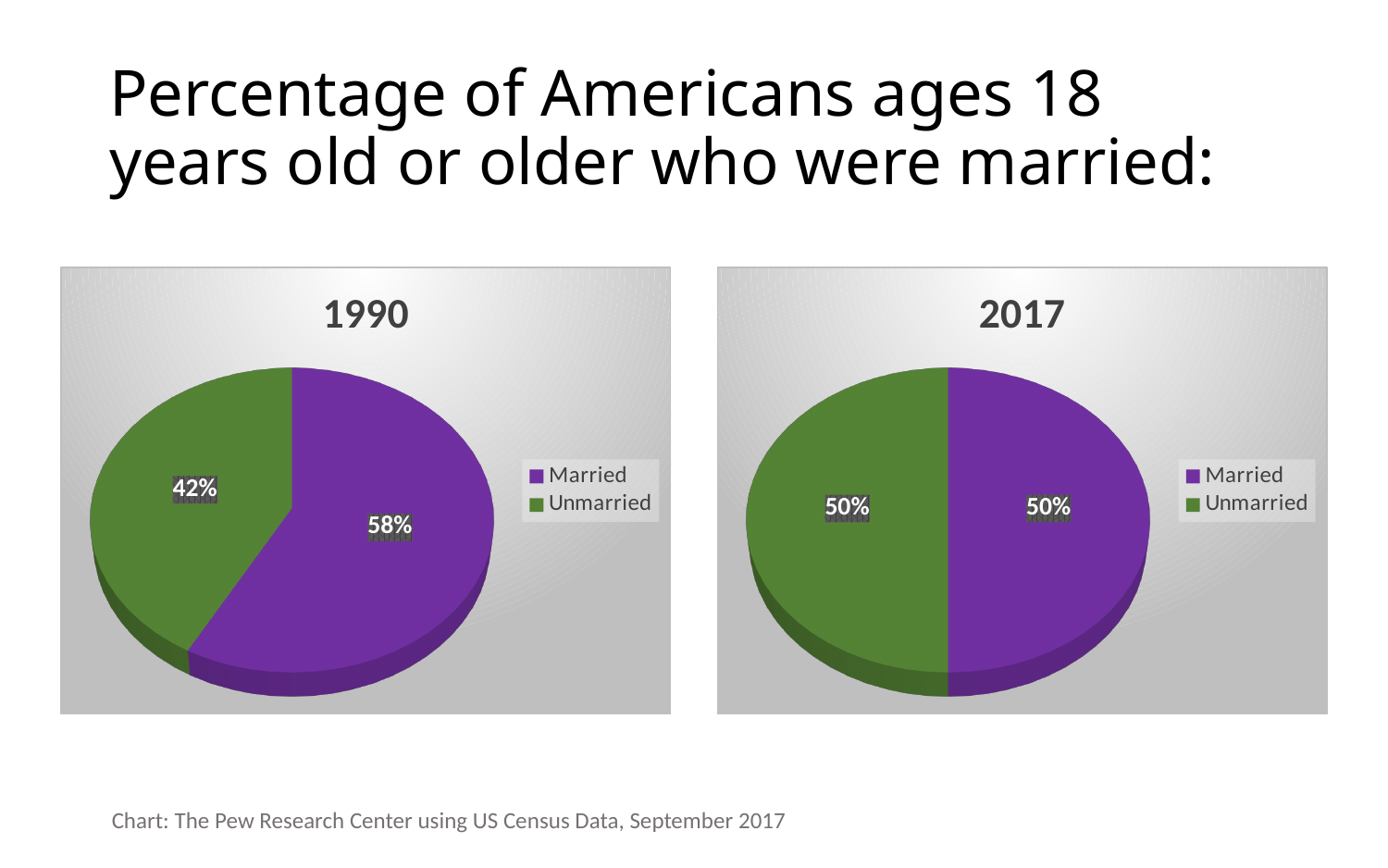
In the 1990 chart, what is the difference between the Married and Unmarried percentages? 16% What kind of chart is the 2017 chart? Pie chart In the 2017 chart, what colour is the Married slice? Purple In the 1990 chart, which slice is the largest? Married How many slices does the 1990 chart have? 2 In the 1990 chart, which slice is the smallest? Unmarried In the 1990 chart, what percentage were Unmarried? 42% In the 2017 chart, what percentage were Married? 50% How many entries does the legend of the 2017 chart list? 2 In the 1990 chart, which is larger, Married or Unmarried? Married In the 2017 chart, what percentage were Unmarried? 50% In the 1990 chart, what percentage were Married? 58%